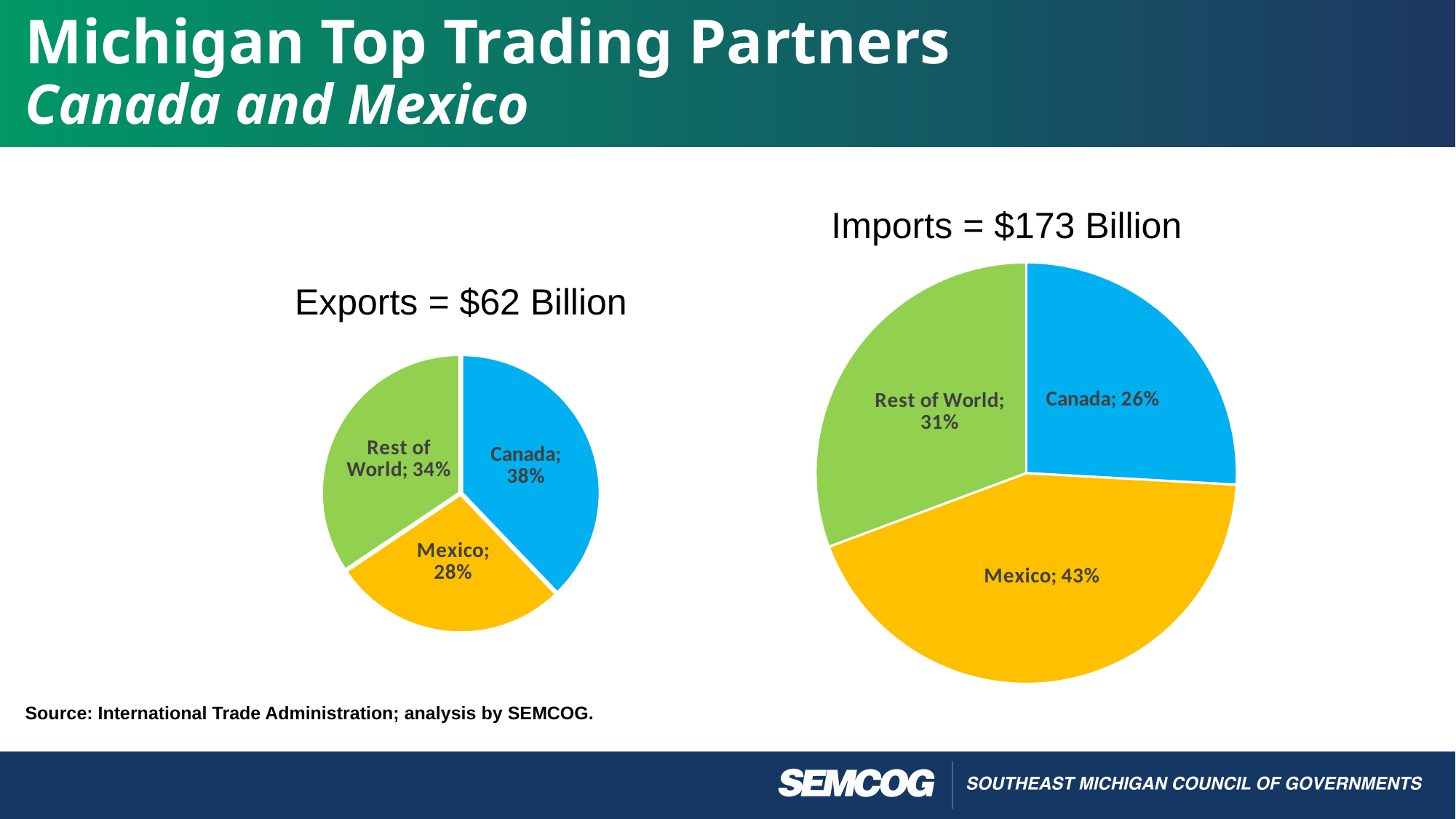
What total value is given in the title of the Imports chart? $173 Billion In the Exports pie chart, which is larger, Rest of World or Mexico? Rest of World In the Exports pie chart, what share does Mexico have? 28% What total value is given in the title of the Exports chart? $62 Billion In the Exports pie chart, what share does Canada have? 38% In the Exports pie chart, which slice is the largest? Canada In the Imports pie chart, which slice is the smallest? Canada In the Imports pie chart, what is the difference between Mexico's share and Canada's share? 17% How many slices does the Exports pie chart have? 3 What kind of chart is used for Imports? Pie chart In the Imports pie chart, what share does Mexico have? 43% In the Imports pie chart, what share does Rest of World have? 31%